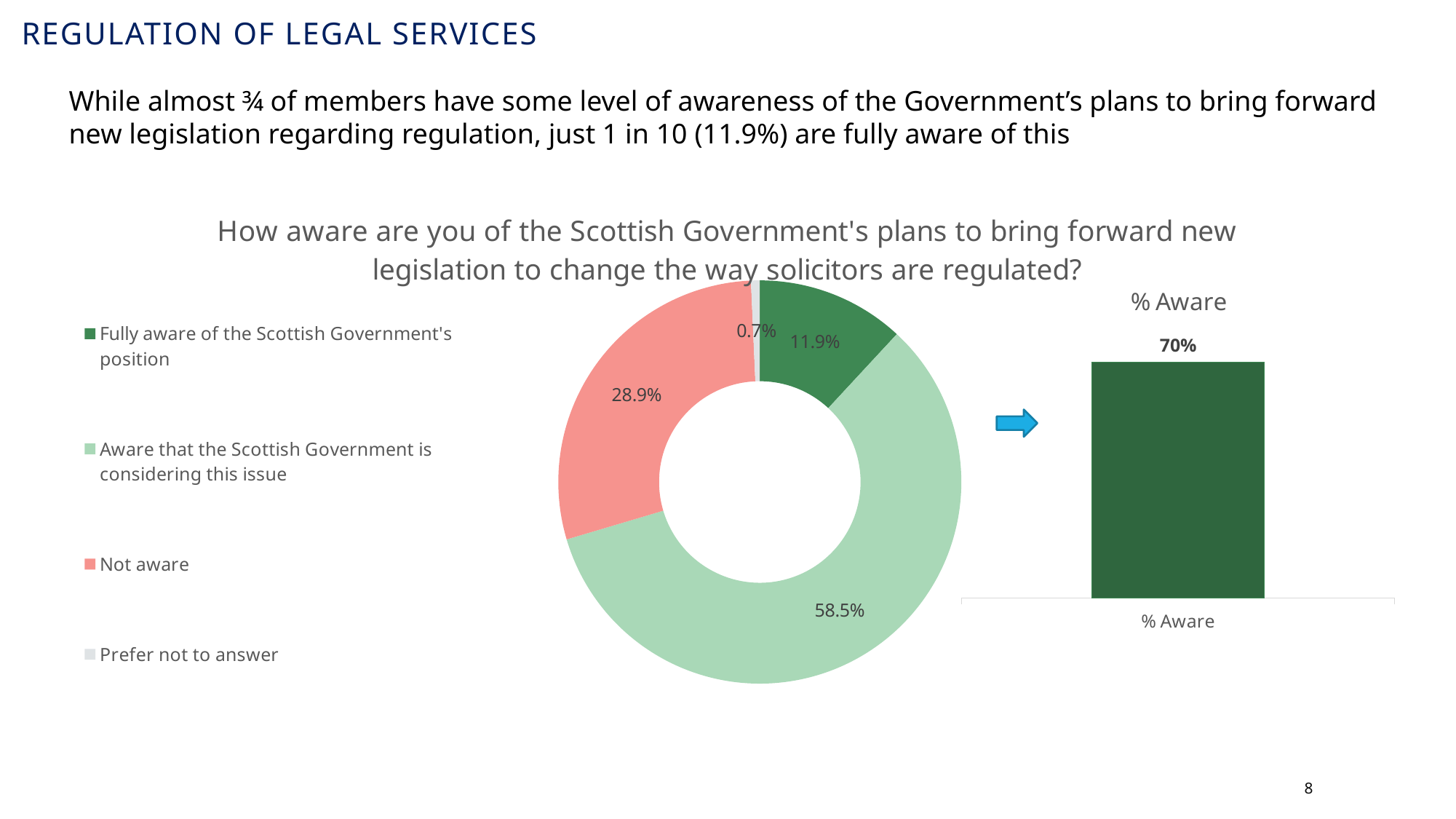
In the doughnut chart on the left, which category has the largest share? Aware that the Scottish Government is considering this issue In the doughnut chart on the left, which is larger: the share for 'Not aware' or the share for 'Fully aware of the Scottish Government's position'? Not aware In the doughnut chart on the left, what percentage of respondents are fully aware of the Scottish Government's position? 11.9% What type of chart is the chart on the left of the slide? Doughnut chart What type of chart is the '% Aware' chart on the right of the slide? Bar chart In the doughnut chart on the left, what is the difference in percentage points between 'Not aware' and 'Fully aware of the Scottish Government's position'? 17 percentage points In the doughnut chart on the left, what percentage of respondents preferred not to answer? 0.7% In the '% Aware' chart on the right, what value is shown for the '% Aware' bar? 70% In the doughnut chart on the left, which category has the smallest share? Prefer not to answer In the doughnut chart on the left, what percentage of respondents are not aware? 28.9% In the doughnut chart on the left, what percentage of respondents are aware that the Scottish Government is considering this issue? 58.5% How many categories does the legend of the doughnut chart on the left list? 4